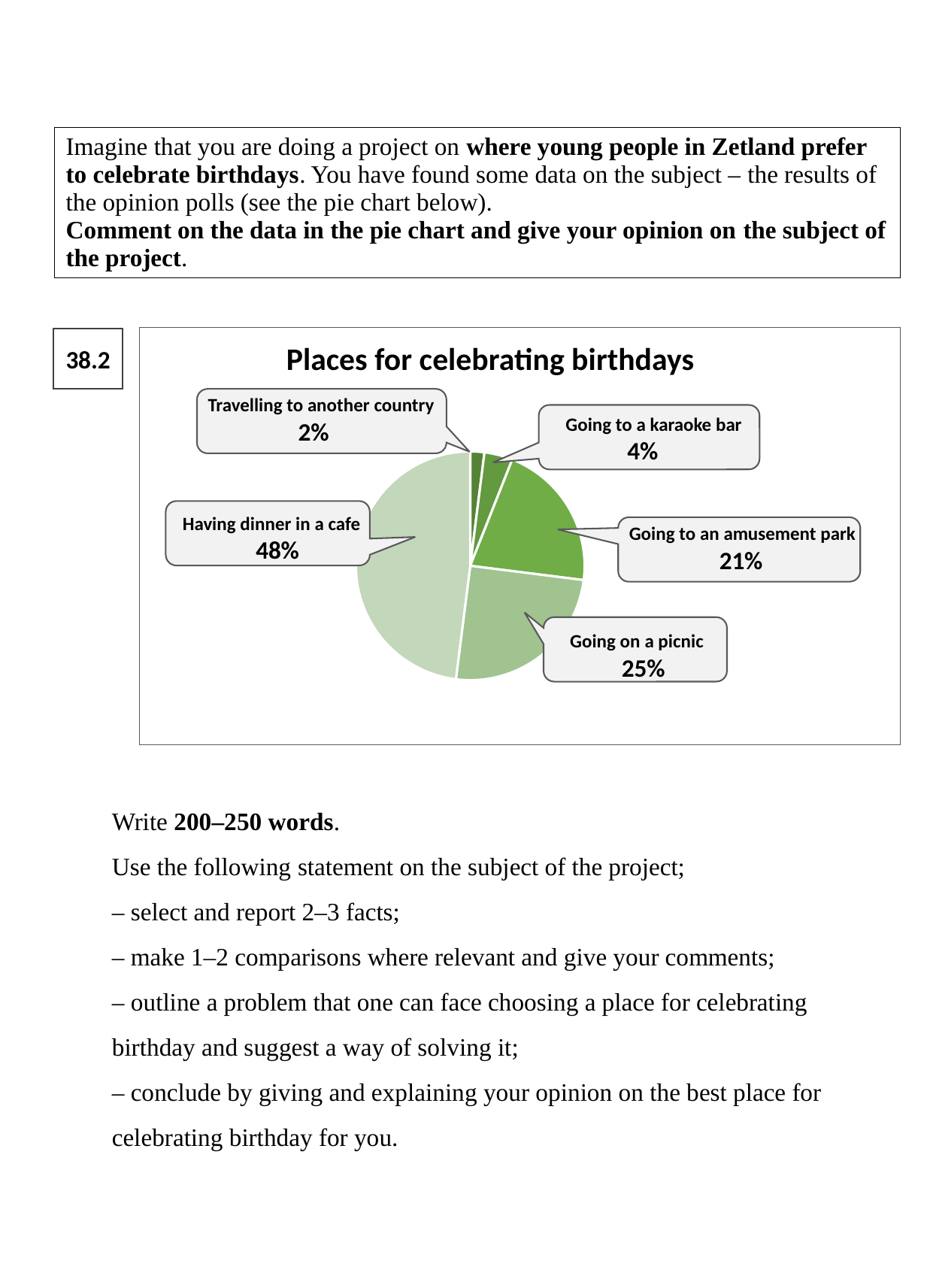
What is the title of the chart? Places for celebrating birthdays What percentage of young people prefer having dinner in a cafe? 48% Which is larger: the share for going on a picnic or the share for going to an amusement park? Going on a picnic What is the difference in percentage points between having dinner in a cafe and going on a picnic? 23 What percentage is shown for going to a karaoke bar? 4% What percentage is shown for travelling to another country? 2% Which place for celebrating birthdays has the largest share? Having dinner in a cafe What share of the pie is going on a picnic? 25% Which place for celebrating birthdays has the smallest share? Travelling to another country What kind of chart is shown on the slide? pie chart What percentage is shown for going to an amusement park? 21% How many categories does the pie chart show? 5